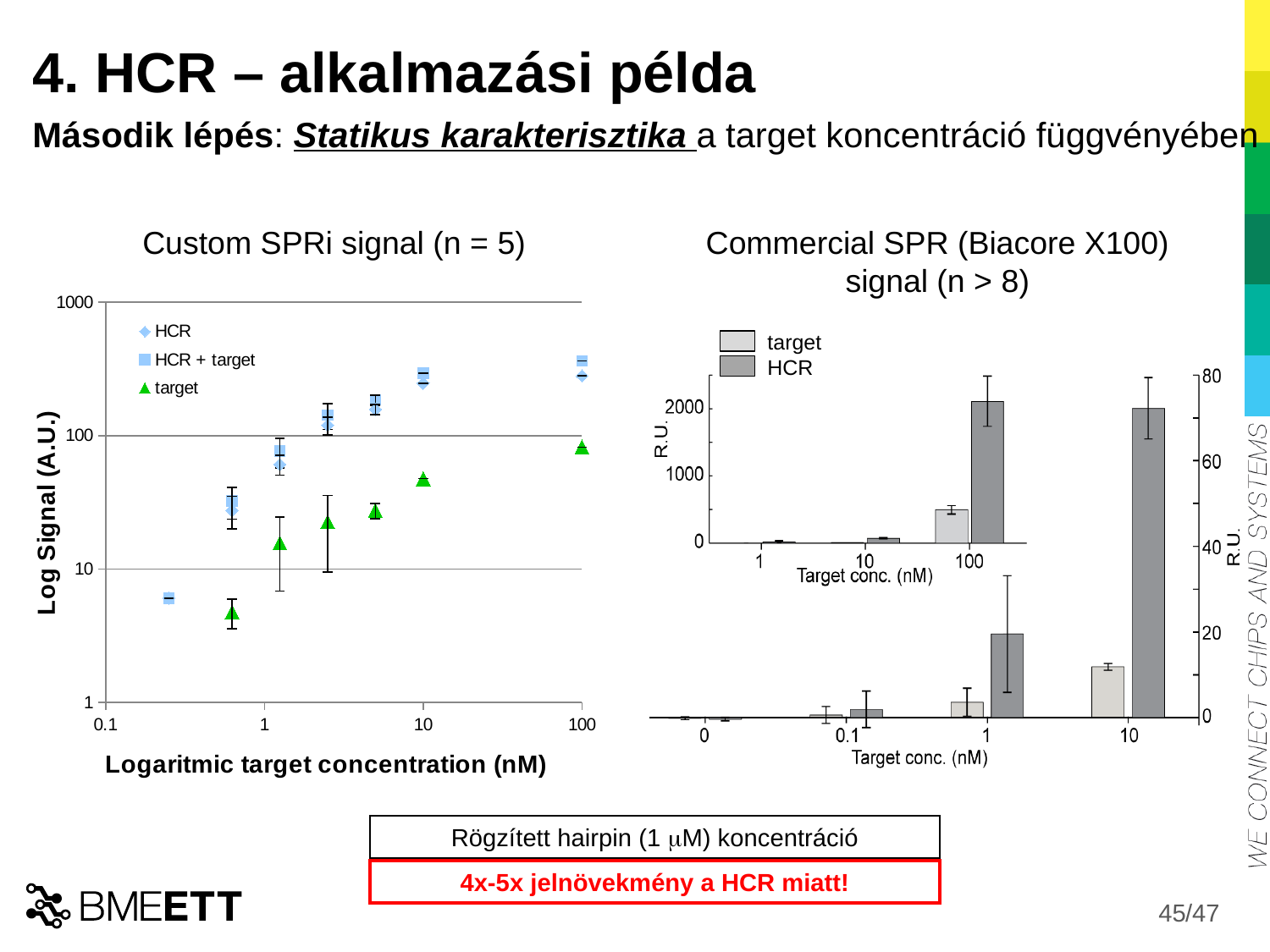
In the 'Custom SPRi signal (n = 5)' chart, does the 'HCR + target' signal rise or fall as the target concentration increases? rise In the 'Commercial SPR (Biacore X100)' chart, is the 'HCR' bar at 10 nM greater or less than 60 R.U.? greater What kind of chart is the 'Commercial SPR (Biacore X100) signal (n > 8)' chart on the right? bar chart How many series does the legend of the 'Commercial SPR (Biacore X100)' chart list? 2 In the 'Commercial SPR (Biacore X100)' chart, at 10 nM, which bar is larger: 'target' or 'HCR'? HCR What is the x-axis title of the 'Custom SPRi signal (n = 5)' chart? Logaritmic target concentration (nM) What kind of chart is the 'Custom SPRi signal (n = 5)' chart on the left? scatter plot In the 'Custom SPRi signal (n = 5)' chart, at 100 nM, which is larger: 'HCR + target' or 'target'? HCR + target In the 'Custom SPRi signal (n = 5)' chart, is the 'target' value at 100 nM greater or less than 100? less How many series does the legend of the 'Custom SPRi signal (n = 5)' chart list? 3 In the 'Custom SPRi signal (n = 5)' chart, is the 'HCR + target' value at 100 nM greater or less than 100? greater